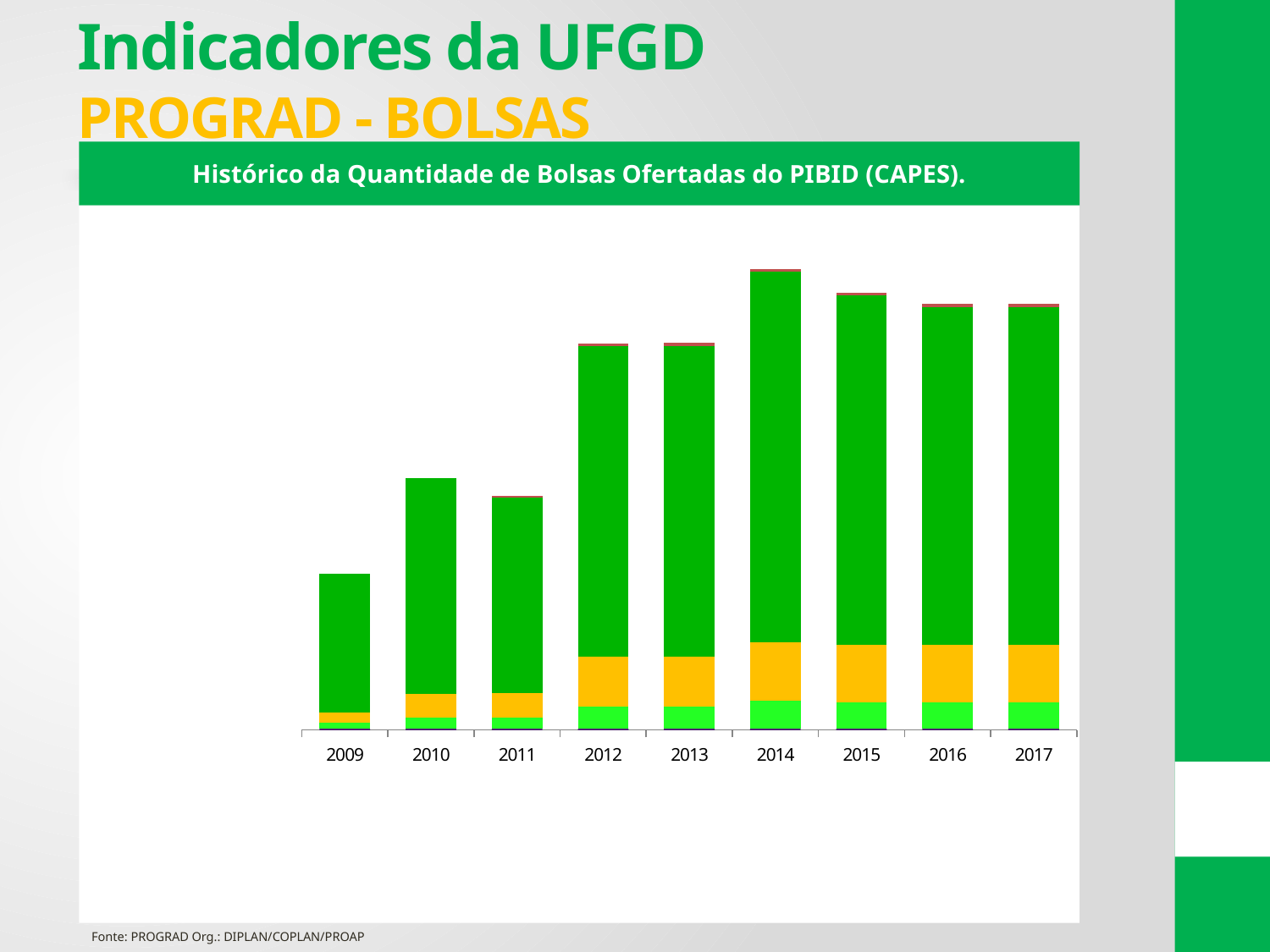
Which year has the shortest bar in the chart? 2009 Which year has the tallest bar in the chart? 2014 Which bar is taller, 2009 or 2010? 2010 Do the bar totals rise or fall from 2009 to 2014? Rise How many years are shown on the x axis of the chart? 9 What is the first year shown on the x axis? 2009 What is the last year shown on the x axis? 2017 What is the title of the chart? Histórico da Quantidade de Bolsas Ofertadas do PIBID (CAPES). What kind of chart is shown on the slide? Stacked bar chart Which bar is taller, 2011 or 2013? 2013 Which bar is taller, 2014 or 2015? 2014